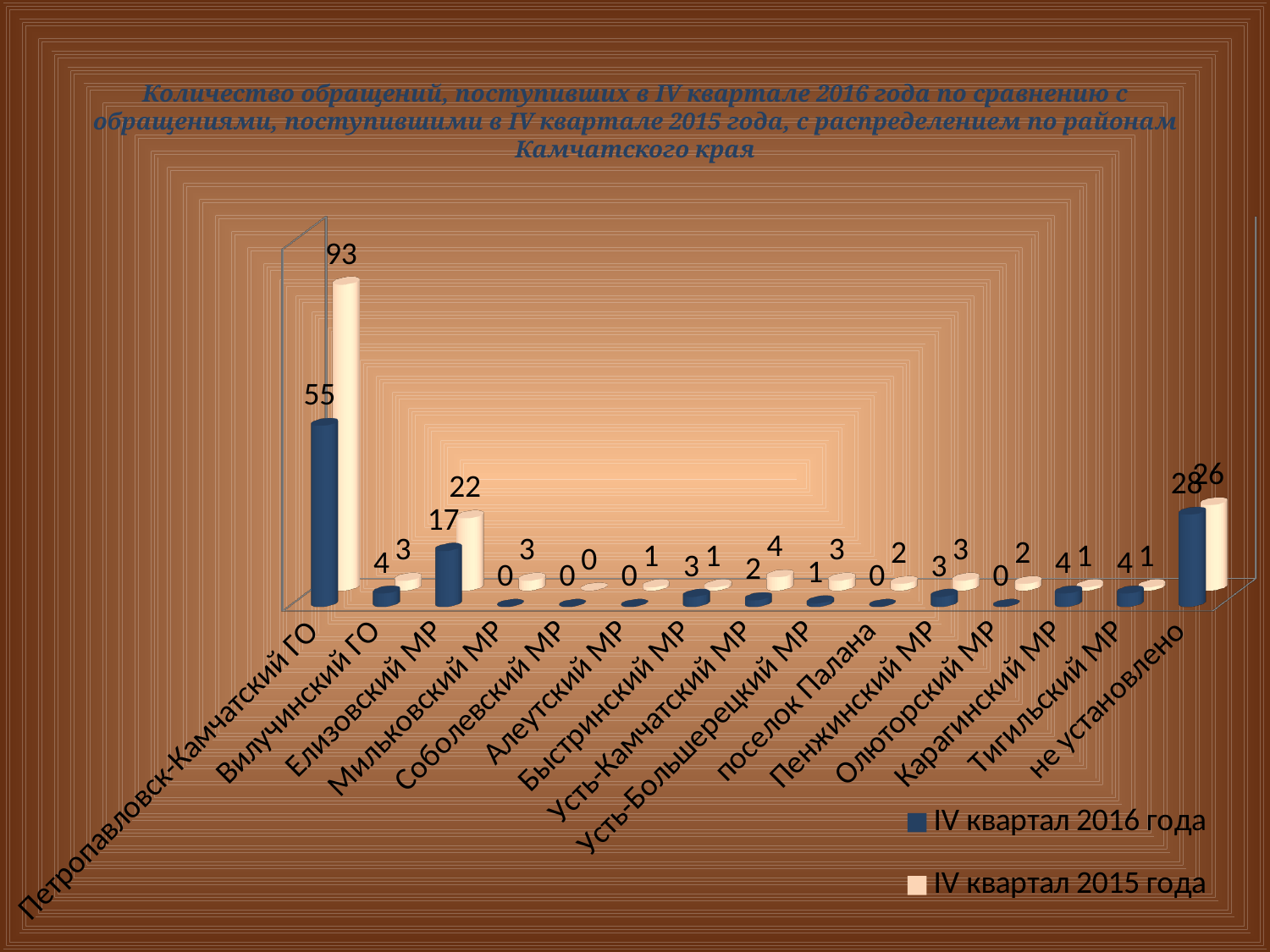
Which series is shown in dark blue according to the legend? IV квартал 2016 года What is the value for Елизовский МР in the IV квартал 2015 года series? 22 How many districts (categories) are shown on the x axis? 15 What is the value for Петропавловск-Камчатский ГО in the IV квартал 2015 года series? 93 Which is larger for Елизовский МР: the IV квартал 2016 года value or the IV квартал 2015 года value? IV квартал 2015 года What is the value for не установлено in the IV квартал 2016 года series? 28 How many series does the legend list? 2 What is the difference between the IV квартал 2016 года and IV квартал 2015 года values for не установлено? 2 Which category has the highest value in the IV квартал 2016 года series? Петропавловск-Камчатский ГО What is the difference between the IV квартал 2015 года and IV квартал 2016 года values for Петропавловск-Камчатский ГО? 38 What kind of chart is shown on the slide? bar chart What is the value for Петропавловск-Камчатский ГО in the IV квартал 2016 года series? 55